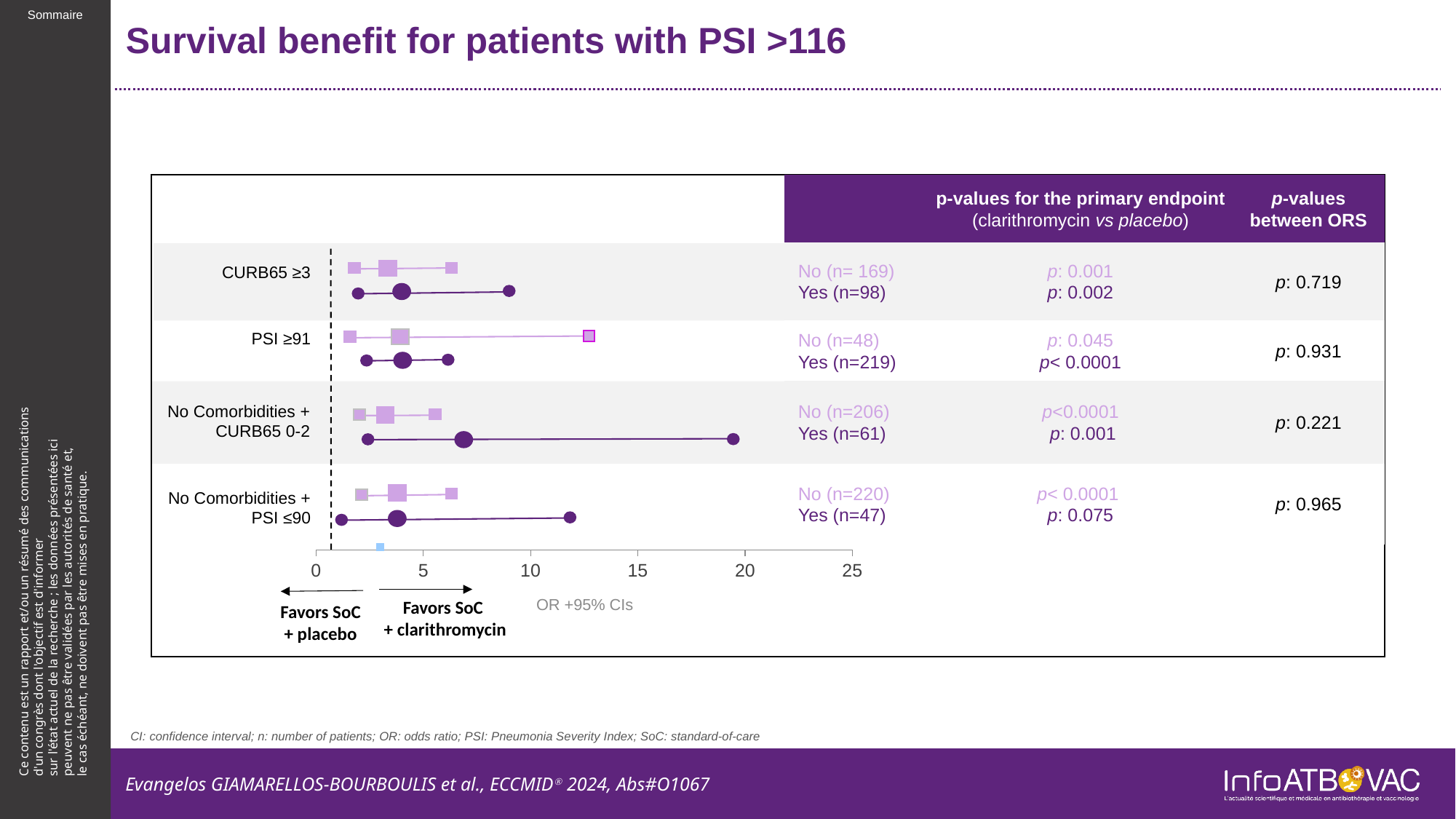
Is the upper confidence limit for the 'No' group in the 'PSI ≥91' subgroup greater or less than 10? greater What is the number of patients in the 'Yes' group of the PSI ≥91 subgroup? n=219 What is the highest tick value shown on the x axis of the forest plot? 25 Is the upper confidence limit for the 'Yes' group in the 'PSI ≥91' subgroup greater or less than 10? less Which subgroup has the highest odds ratio point estimate for the 'Yes' group (dark circles)? No Comorbidities + CURB65 0-2 Is the upper confidence limit for the 'Yes' group in the 'No Comorbidities + CURB65 0-2' subgroup greater or less than 15? greater How many subgroups are plotted on the forest plot? 4 What kind of chart is shown on the slide? Forest plot (odds ratios with 95% confidence intervals) What is the label of the x axis of the forest plot? OR +95% CIs What is the p-value between ORS for the CURB65 ≥3 subgroup? p: 0.719 What is the p-value for the primary endpoint in the 'No' group of the 'No Comorbidities + PSI ≤90' subgroup? p< 0.0001